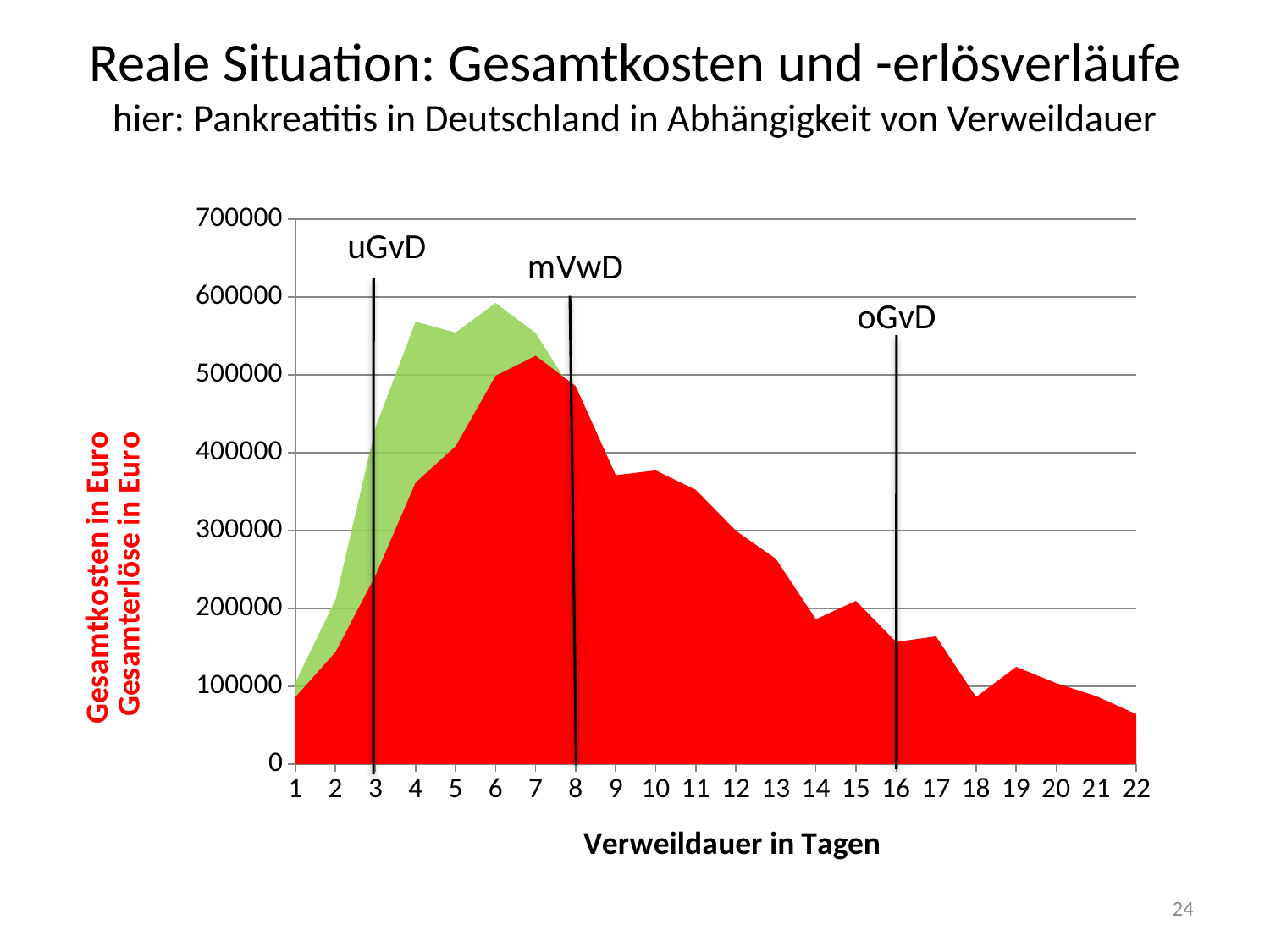
Is the red (Gesamtkosten) value at day 22 greater or less than 100000? less What kind of chart is shown on the slide? area chart Is the red (Gesamtkosten) value at day 7 greater or less than 500000? greater Is the green (Gesamterlöse) value at day 6 greater or less than 500000? greater What is the title of the x axis? Verweildauer in Tagen Do the red (Gesamtkosten) values rise or fall from day 10 to day 22? fall How many days (x-axis categories) are plotted on the chart? 22 At day 4, which is larger: the green (Gesamterlöse) value or the red (Gesamtkosten) value? green (Gesamterlöse) At which day does the red (Gesamtkosten) area reach its highest value? 7 At which day does the green (Gesamterlöse) area reach its highest value? 6